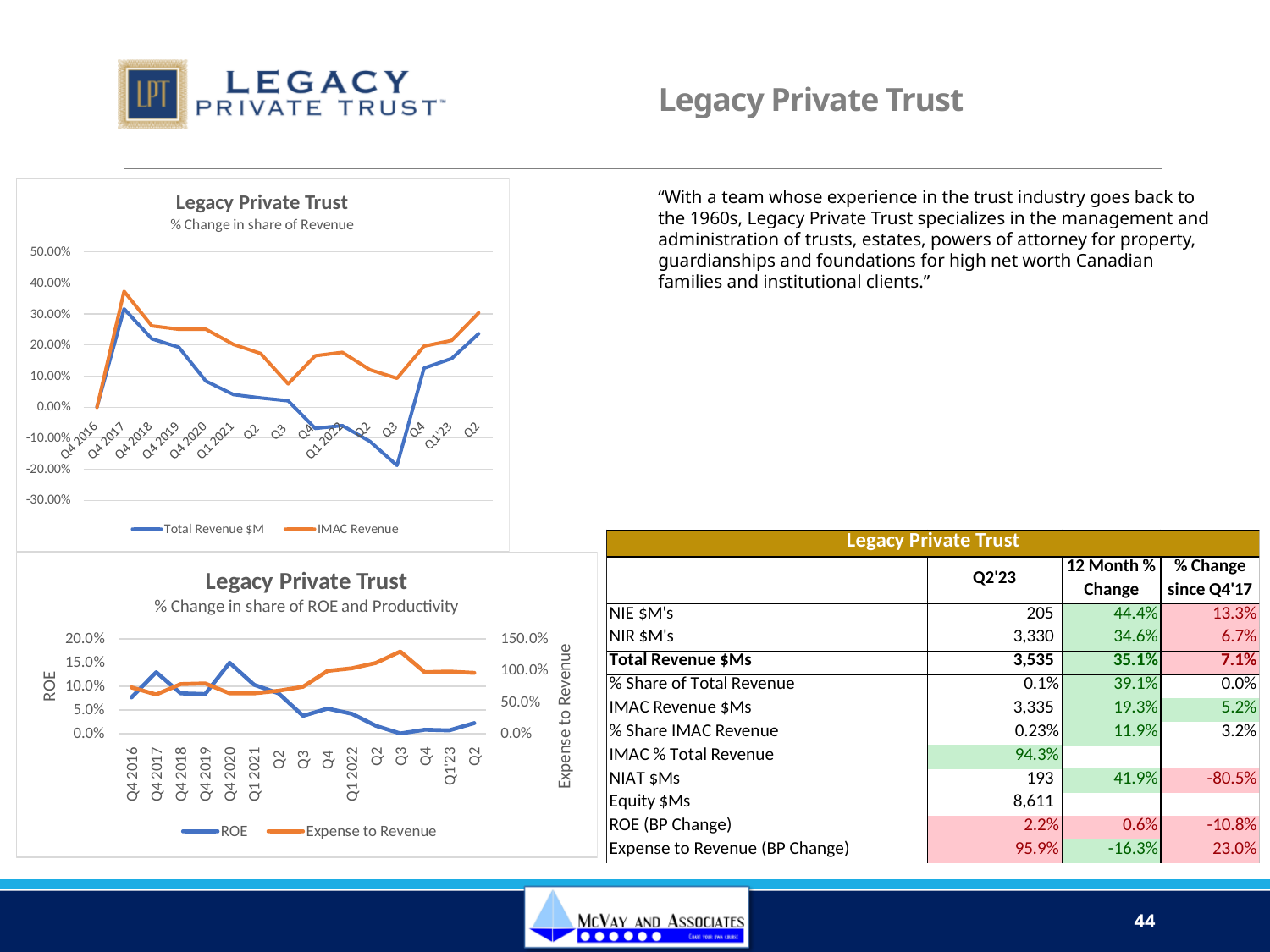
In the bottom chart (% Change in share of ROE and Productivity), is the value for ROE at Q4 2020 greater or less than 10.0%? greater In the top chart (% Change in share of Revenue), is the value for IMAC Revenue at Q4 2017 greater or less than 30.00%? greater In the bottom chart (% Change in share of ROE and Productivity), is the value for Expense to Revenue at Q3 2022 greater or less than 100.0%? greater What kind of chart is the top chart titled 'Legacy Private Trust – % Change in share of Revenue'? Line chart In the top chart (% Change in share of Revenue), does the Total Revenue $M line rise or fall from Q4 2017 to Q3 2022? Fall In the top chart (% Change in share of Revenue), what are the two series named in the legend? Total Revenue $M and IMAC Revenue What is the subtitle of the bottom chart on the slide? % Change in share of ROE and Productivity How many series does the legend of the bottom chart (% Change in share of ROE and Productivity) list? 2 In the top chart (% Change in share of Revenue), which series is higher at Q3 2022, Total Revenue $M or IMAC Revenue? IMAC Revenue How many series does the legend of the top chart (% Change in share of Revenue) list? 2